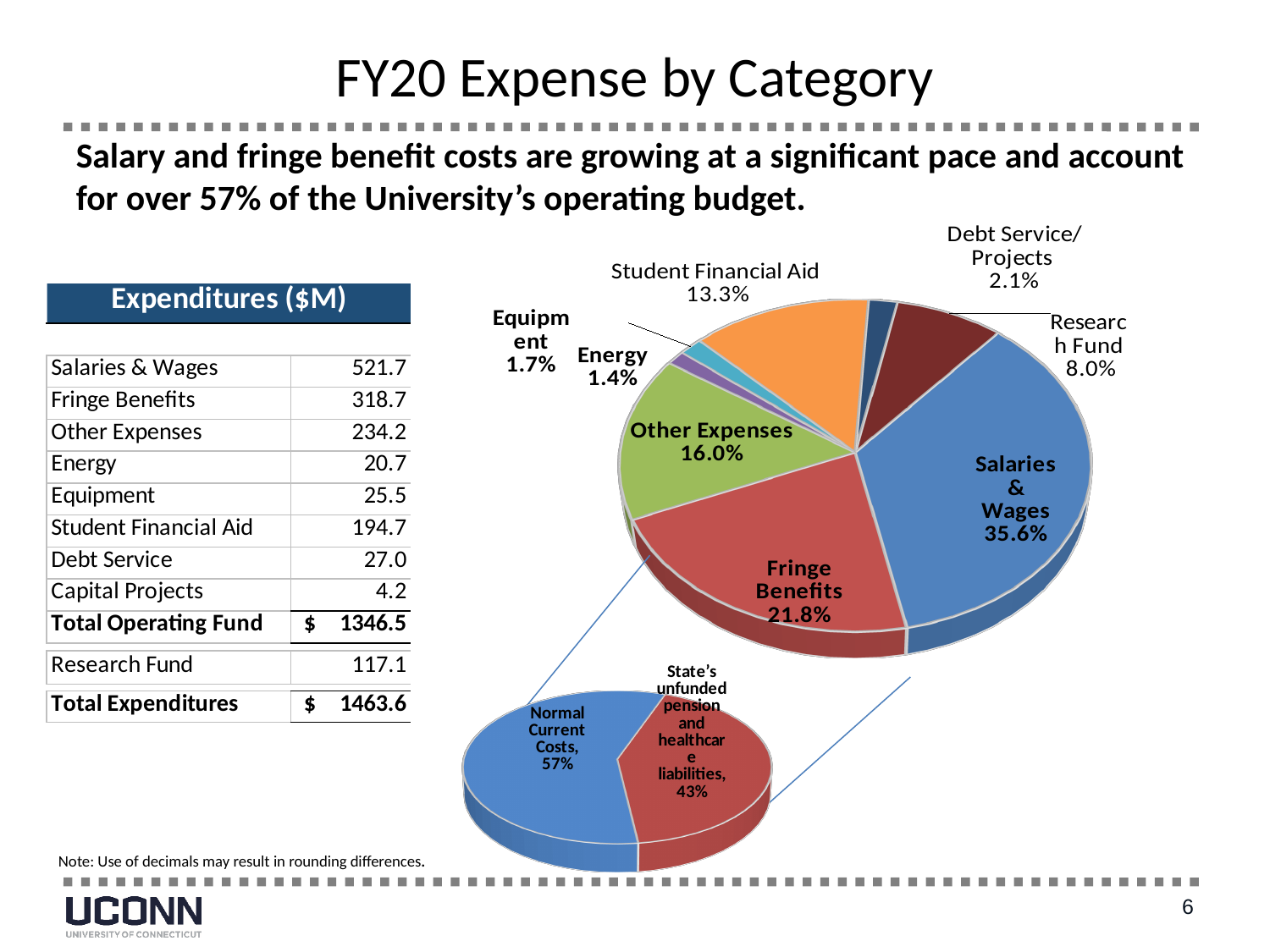
In the large pie chart, what share is labelled for Research Fund? 8.0% In the large pie chart, which category has the smallest slice? Energy In the large pie chart, which slice is larger: Other Expenses or Student Financial Aid? Other Expenses In the large pie chart, what share is labelled for Fringe Benefits? 21.8% In the large pie chart, what is the difference in percentage points between Salaries & Wages and Fringe Benefits? 13.8 In the small pie chart at the bottom, what share is labelled for Normal Current Costs? 57% How many slices does the large pie chart have? 8 What type of chart is the large chart on the slide? Pie chart In the large pie chart, what share is labelled for Student Financial Aid? 13.3% In the large pie chart, what share is labelled for Salaries & Wages? 35.6% In the large pie chart, which category has the largest slice? Salaries & Wages In the small pie chart at the bottom, what share is labelled for State's unfunded pension and healthcare liabilities? 43%